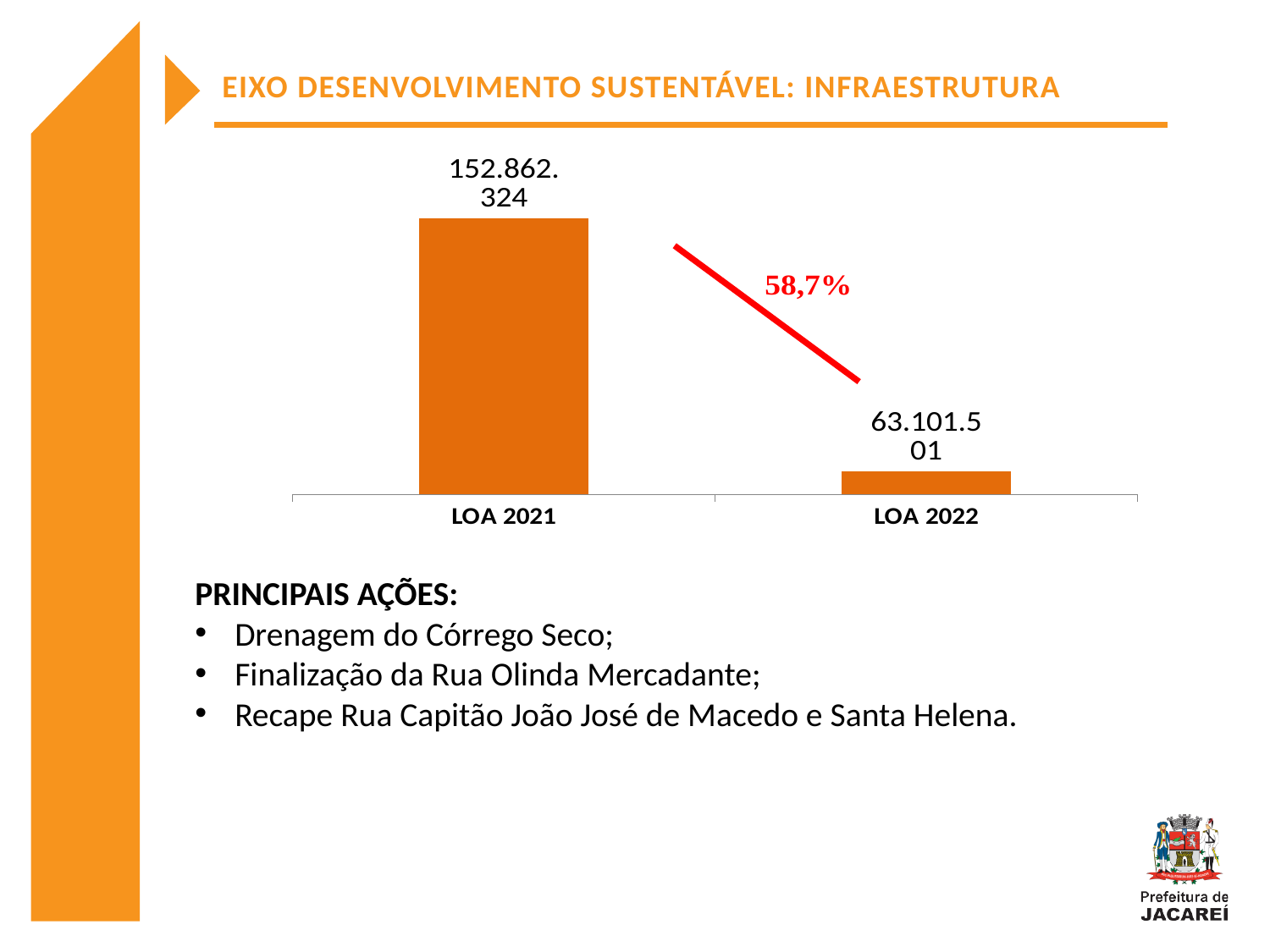
What percentage is written in red next to the line between the two bars? 58,7% What kind of chart is shown on the slide? Bar chart What is the difference between the values for LOA 2021 and LOA 2022? 89.760.823 Which category has the highest value? LOA 2021 Do the values rise or fall from LOA 2021 to LOA 2022? Fall What is the value for LOA 2022? 63.101.501 What colour are the bars in the chart? Orange What is the value for LOA 2021? 152.862.324 Which category has the lowest value? LOA 2022 Which is larger, the value for LOA 2021 or LOA 2022? LOA 2021 How many categories are shown on the x axis? 2